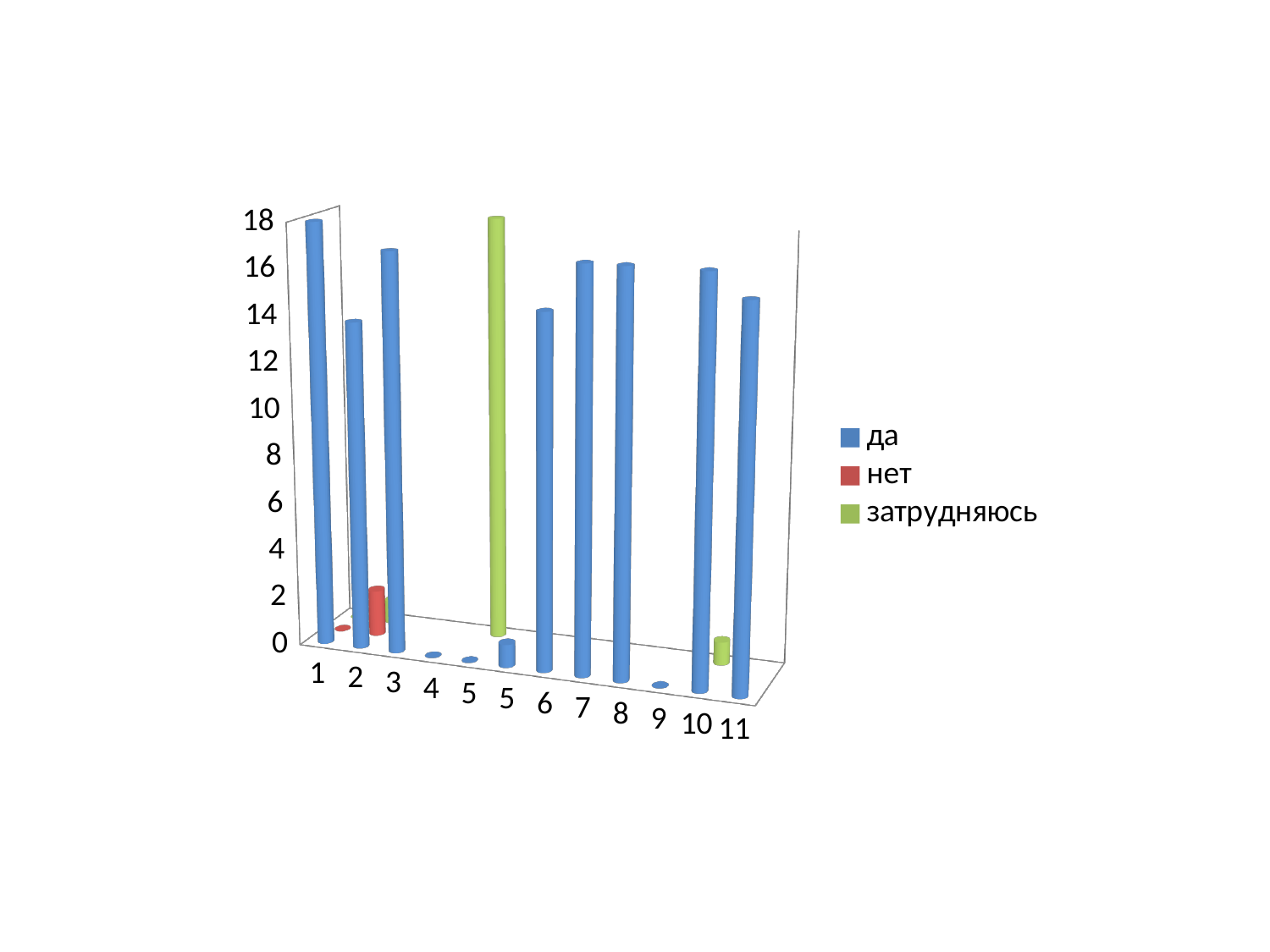
Which is larger, the 'да' value for category 9 or for category 10? category 10 How many series does the legend list? 3 Which series is shown in red in the legend? нет How many categories are shown along the x axis? 12 What kind of chart is shown on the slide? bar chart Which is larger, the 'да' value for category 1 or for category 2? category 1 Which is larger, the 'да' value for category 3 or for category 6? category 3 Is the value of 'да' for category 2 greater or less than 16? less Is the value of 'да' for category 4 greater or less than 2? less Is the value of 'да' for category 11 greater or less than 10? greater Which series is shown in green in the legend? затрудняюсь